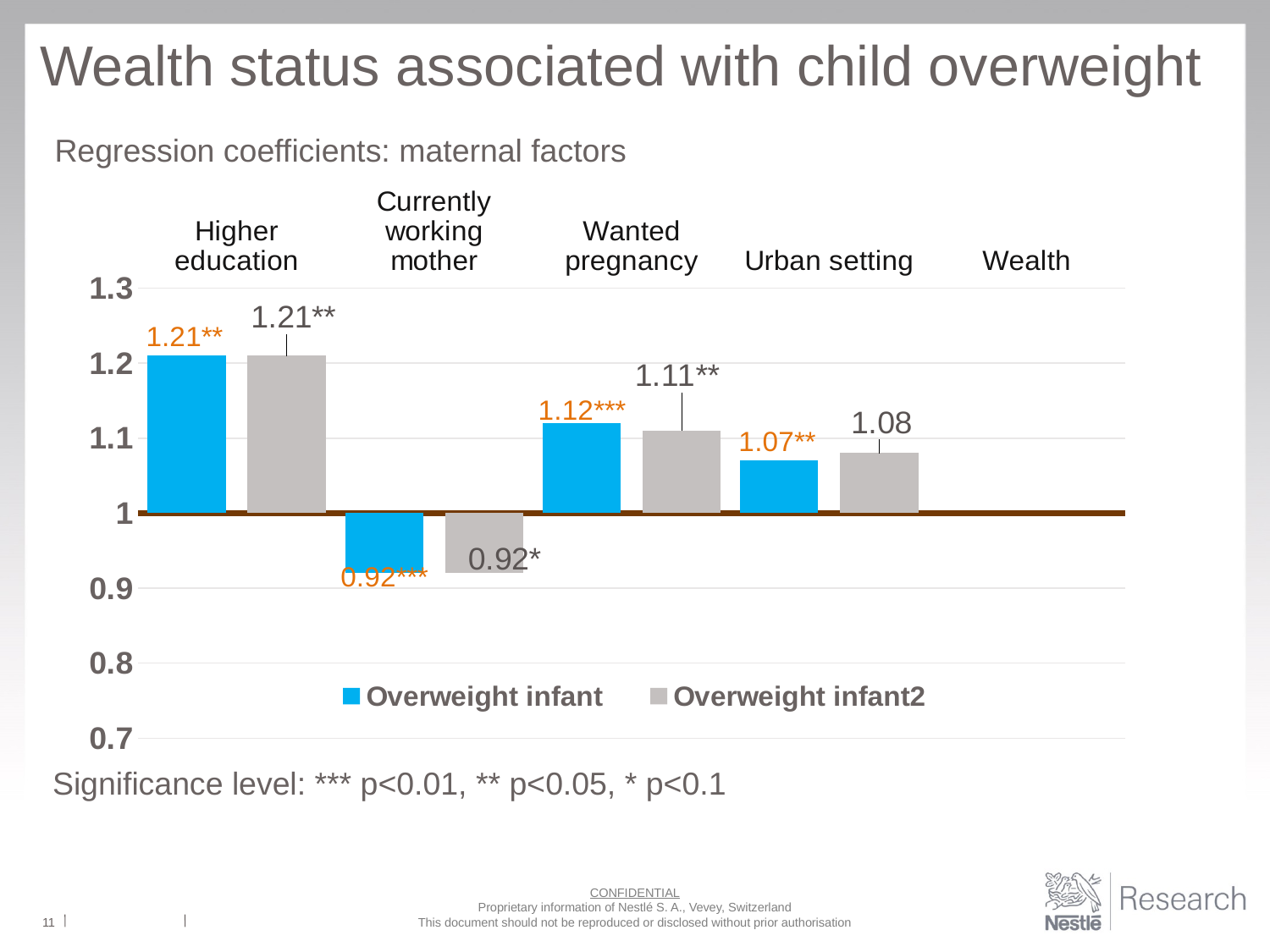
What is the Overweight infant value for Currently working mother? 0.92*** Which category has the lowest Overweight infant2 value? Currently working mother Which category has the highest Overweight infant value? Higher education How many categories are labelled along the x axis? 5 Is the Overweight infant value for Currently working mother greater or less than 1? less What is the Overweight infant value for Higher education? 1.21** What is the Overweight infant2 value for Urban setting? 1.08 What type of chart is shown on the slide? bar chart What is the difference between the Overweight infant values for Higher education and Wanted pregnancy? 0.09 Which series is shown in blue in the legend? Overweight infant What is the Overweight infant2 value for Wanted pregnancy? 1.11** How many series does the legend list? 2